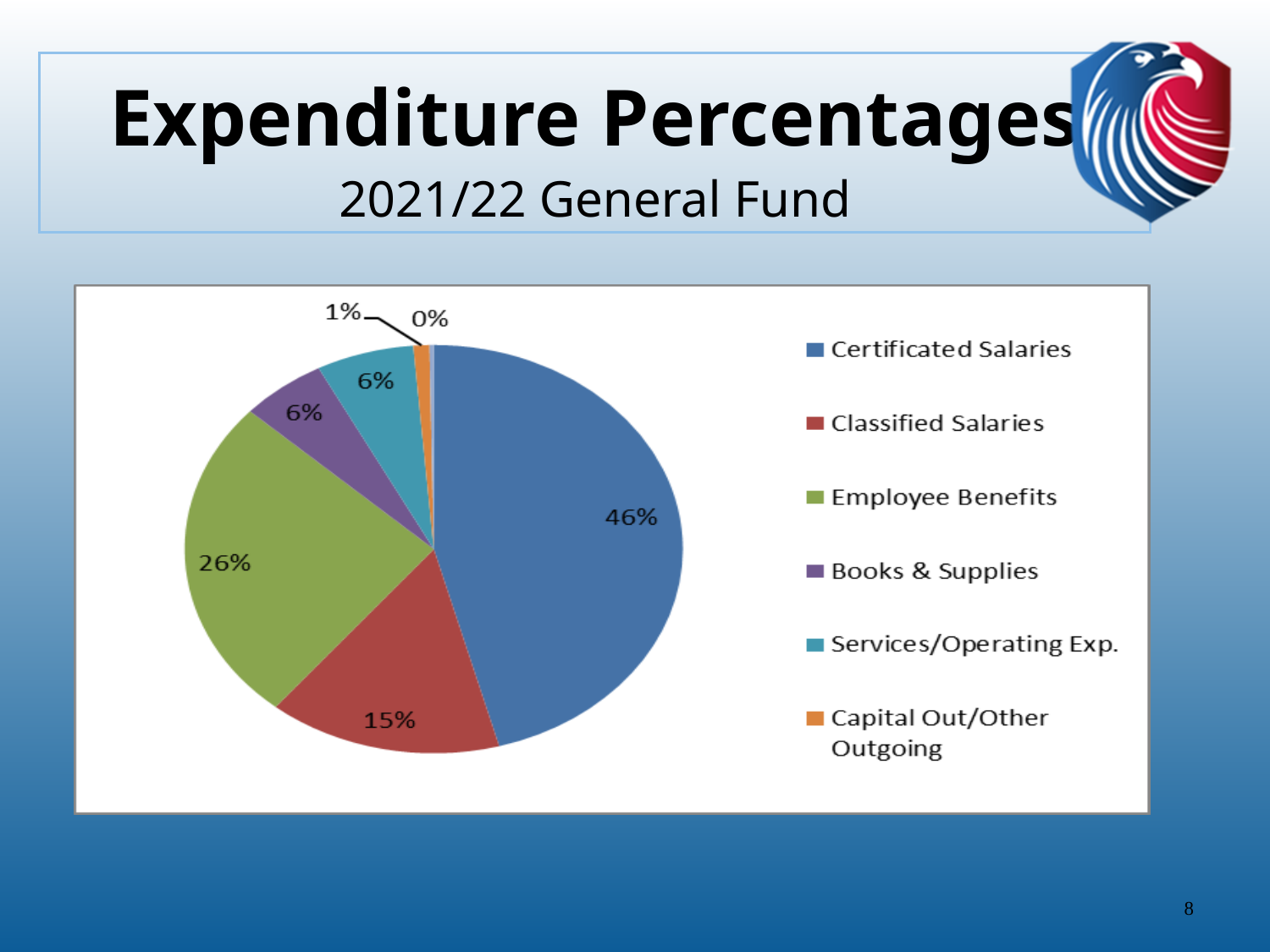
Which of the legend categories has the smallest share of the pie? Capital Out/Other Outgoing What percentage of the 2021/22 General Fund expenditures is Certificated Salaries? 46% Which expenditure category has the largest share of the pie? Certificated Salaries What type of chart is shown on the slide? pie chart What percentage of expenditures is Employee Benefits? 26% What percentage of expenditures is Capital Out/Other Outgoing? 1% What colour represents Employee Benefits in the pie chart? green What is the difference in percentage points between Certificated Salaries and Employee Benefits? 20 Which is larger, the share for Classified Salaries or the share for Employee Benefits? Employee Benefits What percentage of expenditures is Classified Salaries? 15% How many categories does the legend list? 6 What percentage of expenditures is Books & Supplies? 6%